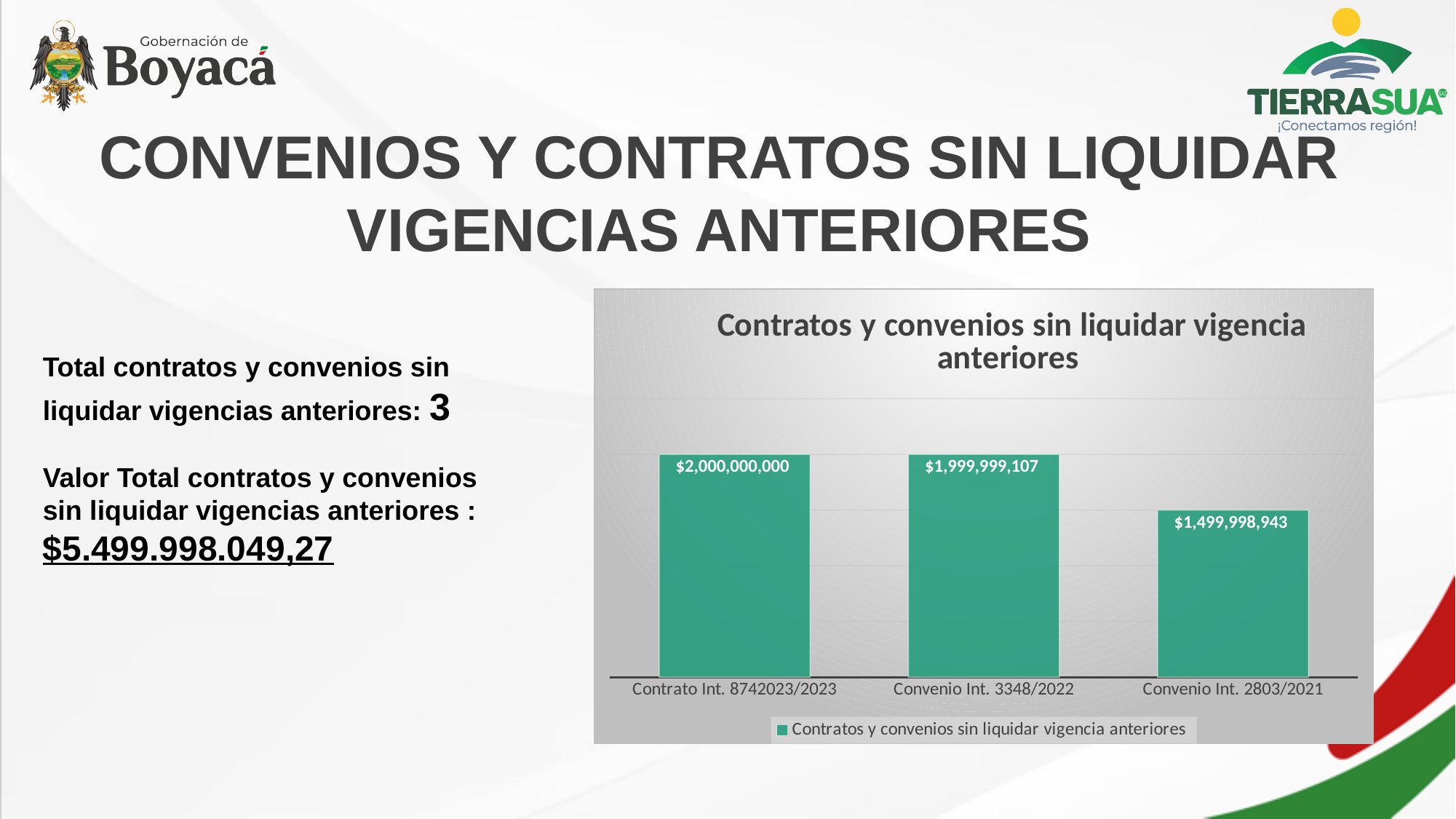
How many categories are shown in the chart? 3 What is the value for Contrato Int. 8742023/2023? $2,000,000,000 Which is larger, the value for Convenio Int. 3348/2022 or the value for Convenio Int. 2803/2021? Convenio Int. 3348/2022 What is the value for Convenio Int. 3348/2022? $1,999,999,107 Which category has the highest value according to the data labels? Contrato Int. 8742023/2023 What kind of chart is shown on the slide? Bar chart How many series does the legend list? 1 What is the difference between the values for Contrato Int. 8742023/2023 and Convenio Int. 2803/2021? $500,001,057 What is the difference between the values for Convenio Int. 3348/2022 and Convenio Int. 2803/2021? $500,000,164 Which category has the lowest value? Convenio Int. 2803/2021 What is the title of the chart? Contratos y convenios sin liquidar vigencia anteriores What is the value for Convenio Int. 2803/2021? $1,499,998,943